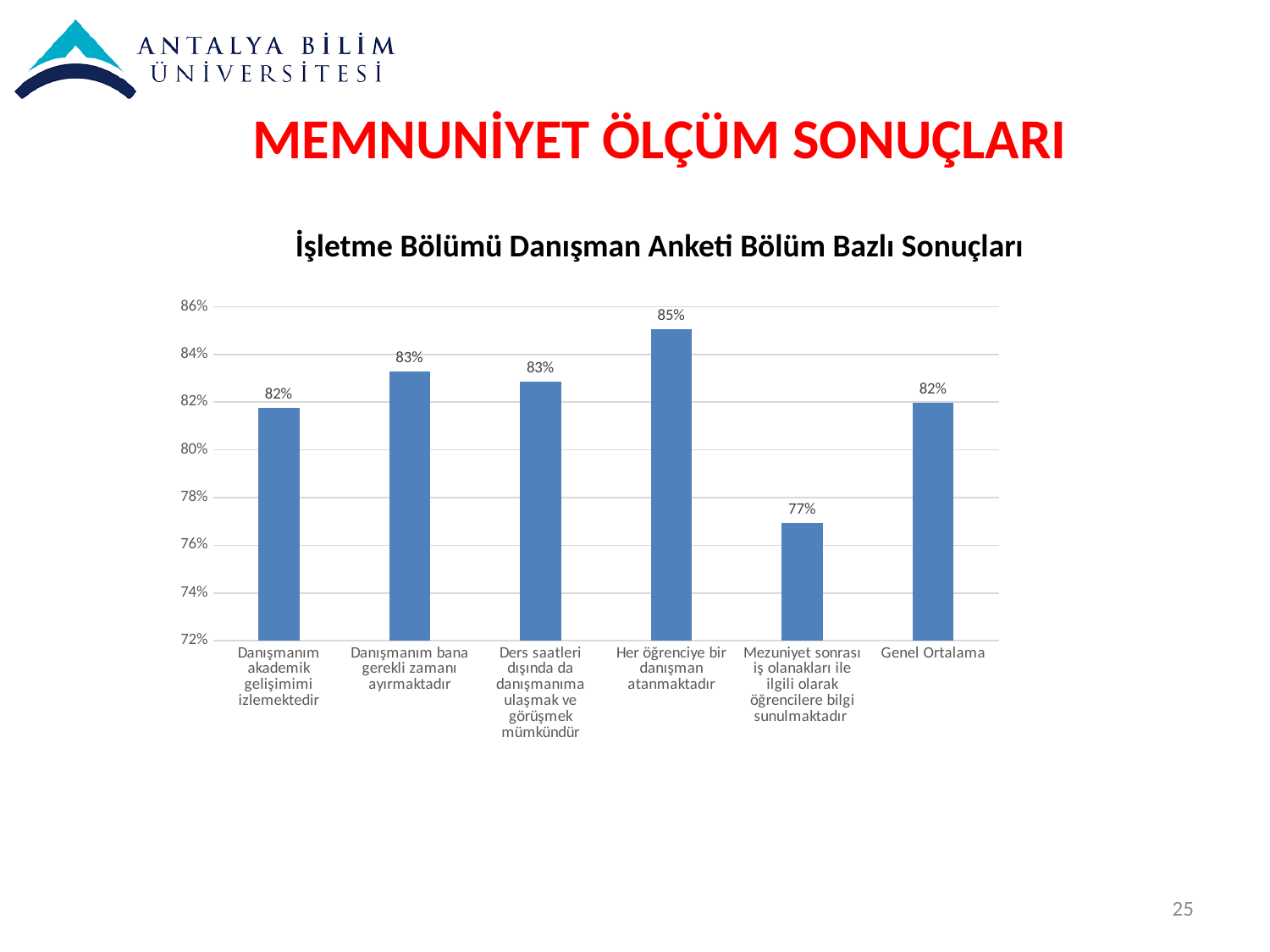
Which category has the highest value? Her öğrenciye bir danışman atanmaktadır Which category has the lowest value? Mezuniyet sonrası iş olanakları ile ilgili olarak öğrencilere bilgi sunulmaktadır What is the title of the chart? İşletme Bölümü Danışman Anketi Bölüm Bazlı Sonuçları What is the value for "Genel Ortalama"? 82% What is the difference between the highest value (85%) and the lowest value (77%)? 8 percentage points Which is larger: the value for "Her öğrenciye bir danışman atanmaktadır" or the value for "Genel Ortalama"? Her öğrenciye bir danışman atanmaktadır What kind of chart is shown on the slide? Bar chart How many categories are shown on the x axis? 6 What is the value for "Danışmanım akademik gelişimimi izlemektedir"? 82% What is the value for "Her öğrenciye bir danışman atanmaktadır"? 85% What is the value for "Mezuniyet sonrası iş olanakları ile ilgili olarak öğrencilere bilgi sunulmaktadır"? 77% Is the value for "Mezuniyet sonrası iş olanakları ile ilgili olarak öğrencilere bilgi sunulmaktadır" greater or less than 78%? less